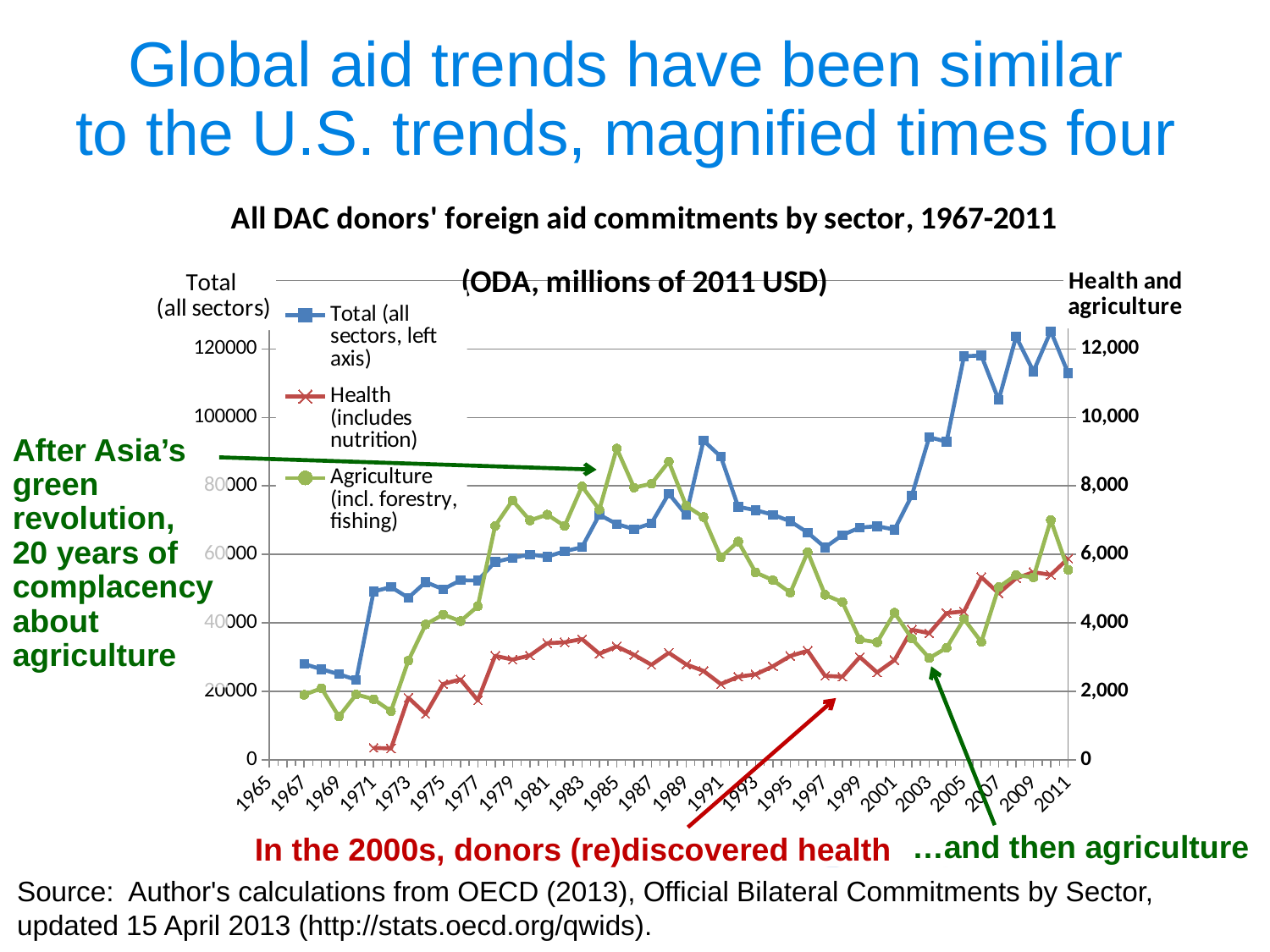
How many series does the chart's legend list? 3 In 1995, which is larger: Health or Agriculture? Agriculture What kind of chart is shown on the slide? Line chart Is the value for Health in 2011 greater or less than 4,000? greater Does the Agriculture series rise or fall between 1985 and 2003? Fall Which axis is the Total (all sectors) series plotted against? Left axis Is the value for Total (all sectors) in 1967 greater or less than 40000? less What is the title of the chart? All DAC donors' foreign aid commitments by sector, 1967-2011 (ODA, millions of 2011 USD) In 1985, which is larger: Agriculture or Health? Agriculture Is the value for Total (all sectors) in 2011 greater or less than 100000? greater